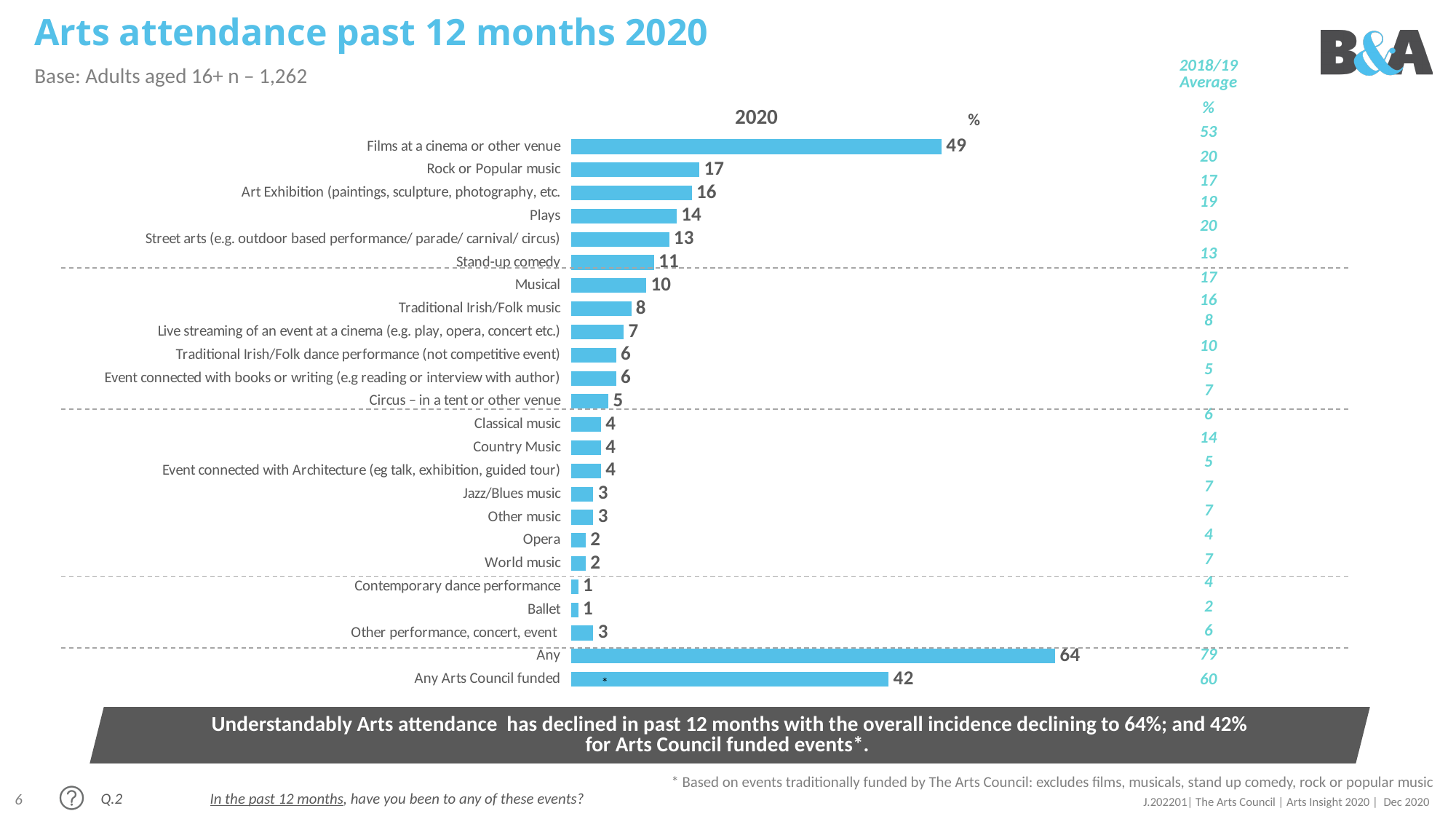
Which category has the highest 2020 value in the chart? Any Which has a larger 2020 value, Plays or Musical? Plays What is the 2018/19 Average shown for Films at a cinema or other venue? 53 What type of chart is shown on the slide? bar chart What is the 2020 value for Stand-up comedy? 11 What is the difference between the 2020 values for Any and Any Arts Council funded? 22 What is the 2020 value for Films at a cinema or other venue? 49 What is the 2020 value for Any Arts Council funded? 42 What is the 2020 value for Rock or Popular music? 17 How many bars are plotted in the chart? 24 What is the difference between the 2020 values for Films at a cinema or other venue and Rock or Popular music? 32 Excluding the 'Any' and 'Any Arts Council funded' bars, which individual event type has the highest 2020 value? Films at a cinema or other venue